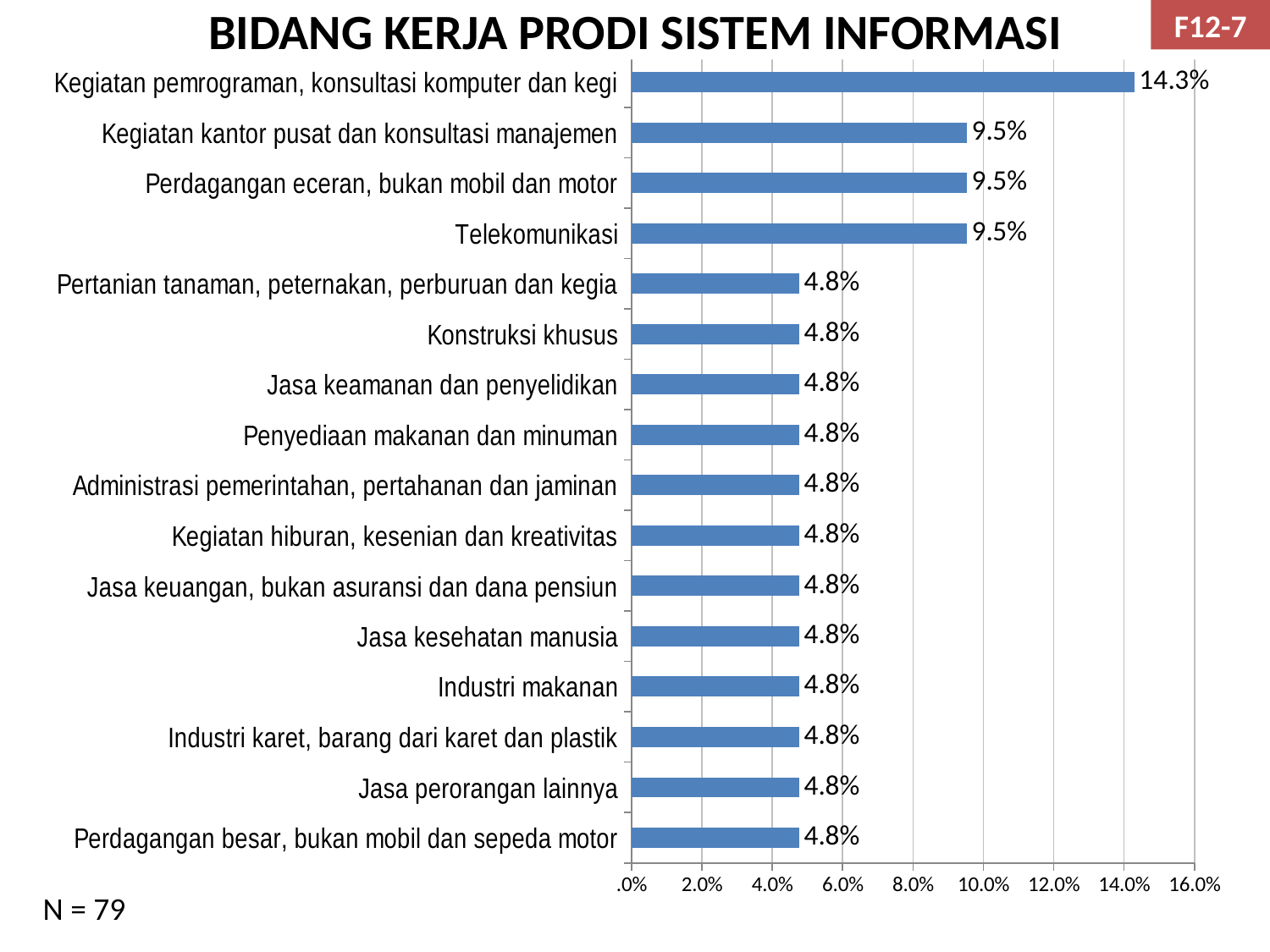
Is the value for Kegiatan pemrograman, konsultasi komputer dan kegi greater or less than 12.0%? greater What is the value for Kegiatan kantor pusat dan konsultasi manajemen? 9.5% Which is larger, the value for Telekomunikasi or the value for Jasa kesehatan manusia? Telekomunikasi What is the highest value shown on the chart? 14.3% What kind of chart is shown on the slide? bar chart What is the difference between the value for Perdagangan eceran, bukan mobil dan motor and the value for Industri makanan? 4.7% What is the value for Telekomunikasi? 9.5% Which category has the highest value? Kegiatan pemrograman, konsultasi komputer dan kegi How many categories are shown on the chart? 16 What is the difference between the value for Kegiatan pemrograman, konsultasi komputer dan kegi and the value for Telekomunikasi? 4.8% What is the title of the chart? BIDANG KERJA PRODI SISTEM INFORMASI What is the value for Konstruksi khusus? 4.8%